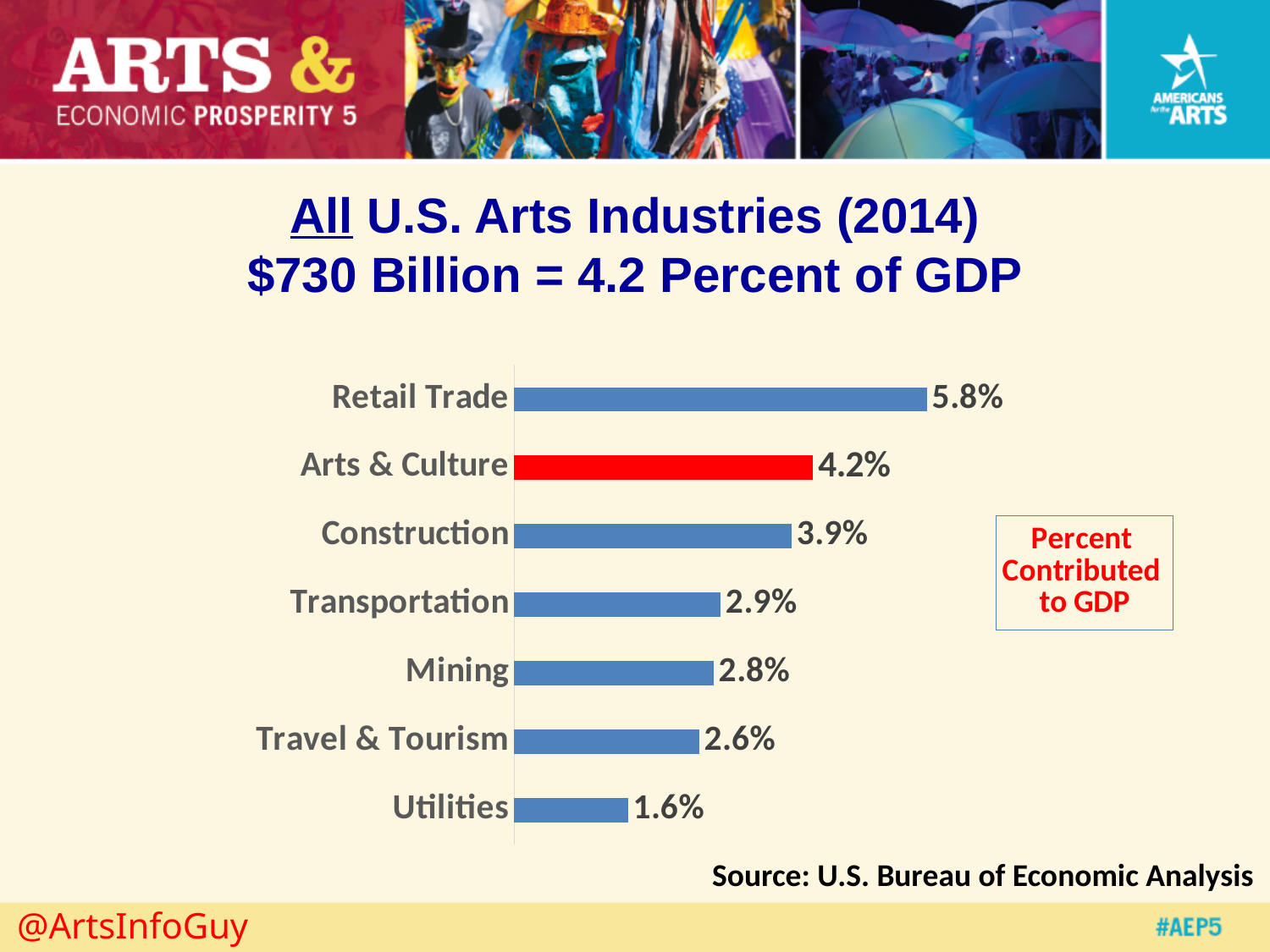
Which category has the lowest percent contributed to GDP? Utilities How many categories are shown in the chart? 7 What kind of chart is shown on the slide? Bar chart Which bar in the chart is coloured red? Arts & Culture Which category has the highest percent contributed to GDP? Retail Trade What is the value shown for Travel & Tourism? 2.6% Which is larger, the value for Transportation or the value for Mining? Transportation What is the difference between the values for Arts & Culture and Construction? 0.3% What is the difference between the values for Retail Trade and Arts & Culture? 1.6% Which is larger, the value for Utilities or the value for Travel & Tourism? Travel & Tourism What percent of GDP does Arts & Culture contribute according to the chart? 4.2% What is the value shown for Construction? 3.9%